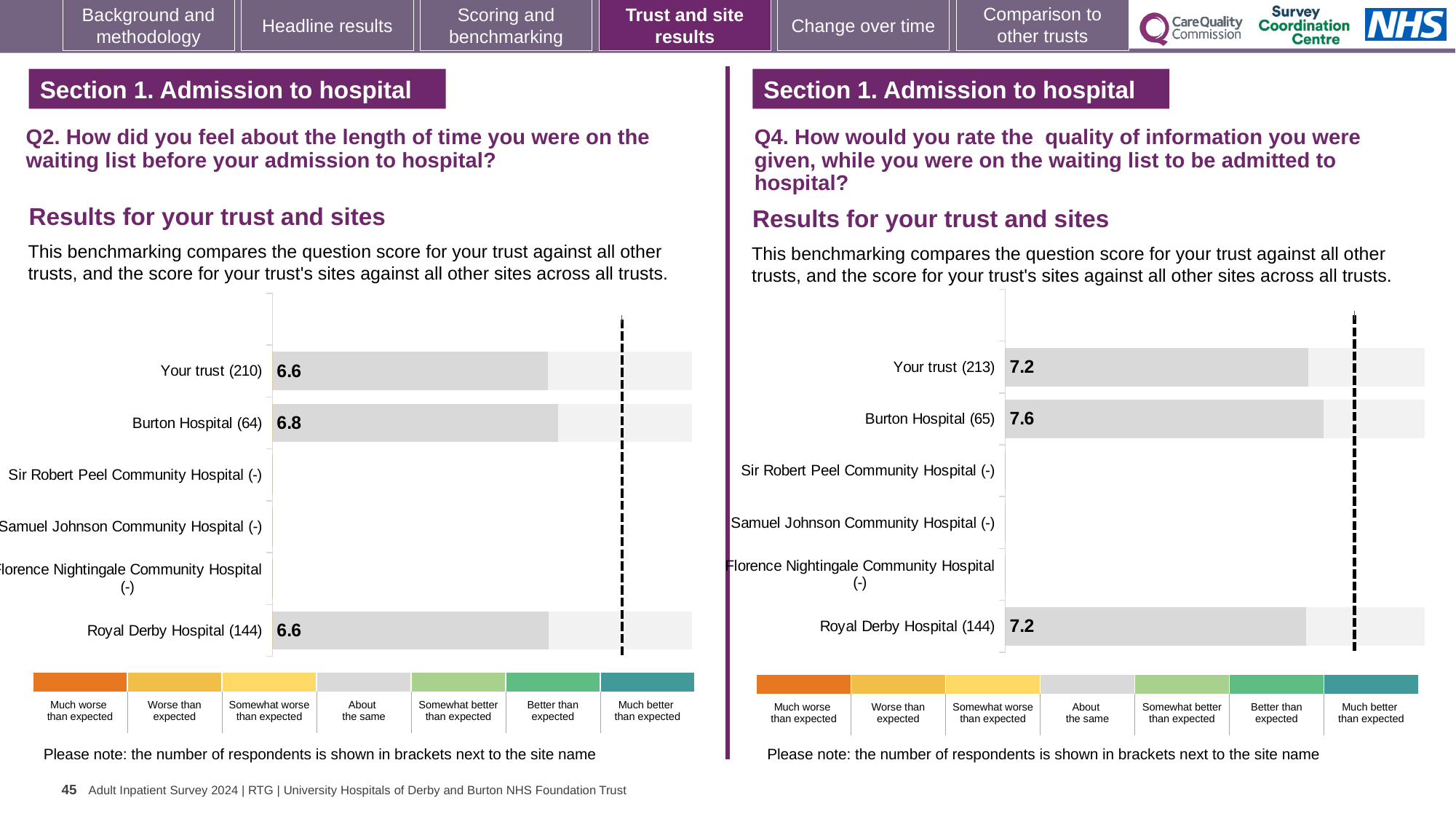
What kind of chart is used on the left (Q2)? Bar chart In the right chart (Q4), what is the difference between the Burton Hospital score and the Royal Derby Hospital score? 0.4 In the right chart (Q4), which is larger: the score for Burton Hospital or the score for Your trust? Burton Hospital In the right chart (Q4), which site with a plotted score has the highest value? Burton Hospital In the right chart (Q4), how many respondents are shown in brackets for Your trust? 213 In the left chart (Q2), what is the difference between the Burton Hospital score and the Your trust score? 0.2 In the right chart (Q4), what is the score for Royal Derby Hospital? 7.2 In the left chart (Q2), what is the score for Burton Hospital? 6.8 In the left chart (Q2), what is the score for Your trust? 6.6 In the right chart (Q4), what is the score for Burton Hospital? 7.6 How many site/trust categories are listed on the y axis of the left chart (Q2)? 6 In the left chart (Q2), how many respondents are shown in brackets for Royal Derby Hospital? 144